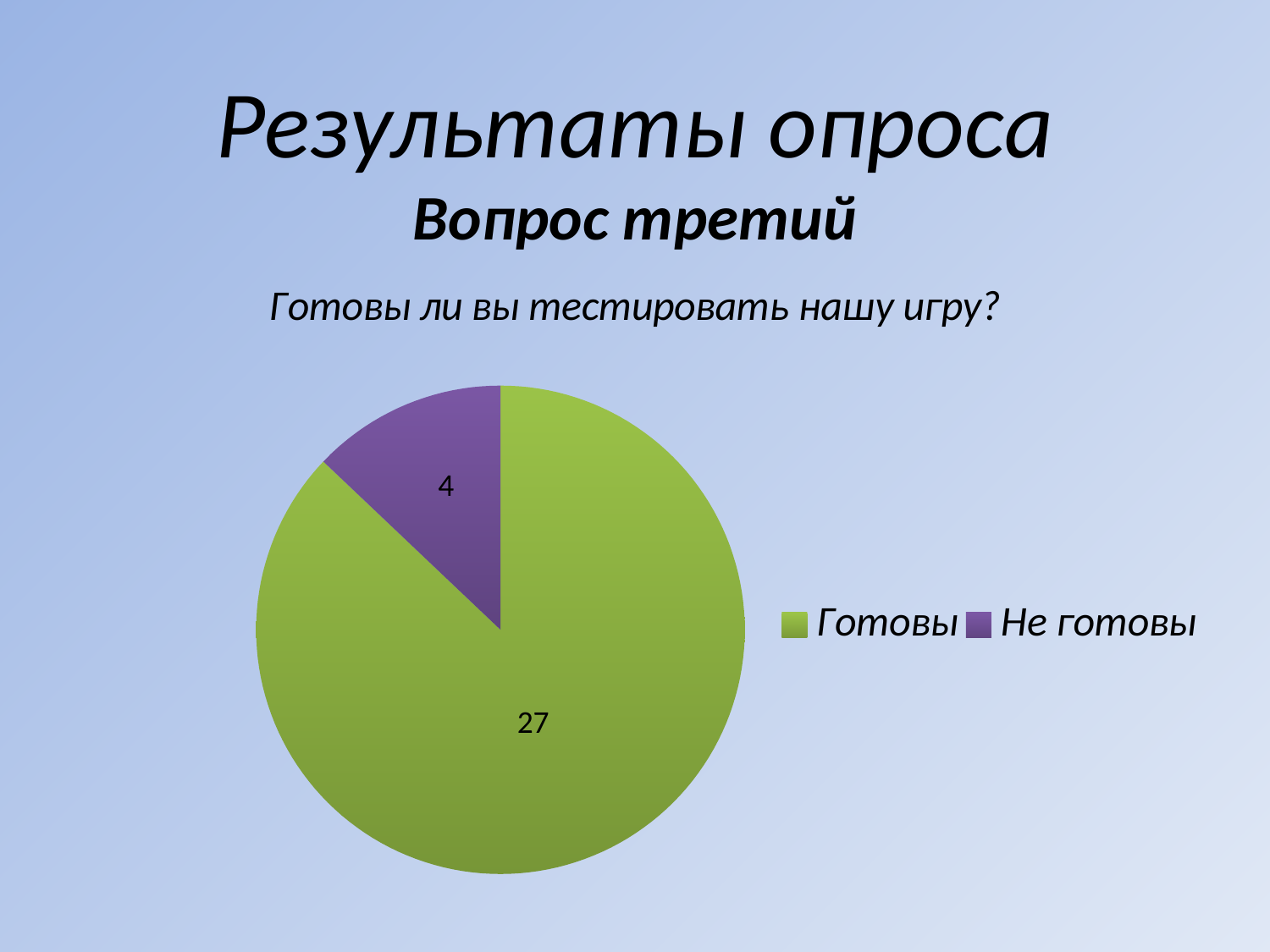
What kind of chart is shown on the slide? pie chart Which category has the smallest slice? Не готовы How many entries does the legend list? 2 What is the total of all slices in the pie chart? 31 What is the difference between the values for Готовы and Не готовы? 23 Which is larger, the value for Готовы or the value for Не готовы? Готовы What is the value for Готовы? 27 Which category has the largest slice? Готовы What is the value for Не готовы? 4 How many slices does the pie chart have? 2 What question is the pie chart answering, as written above it? Готовы ли вы тестировать нашу игру? What colour is the slice for Не готовы? purple